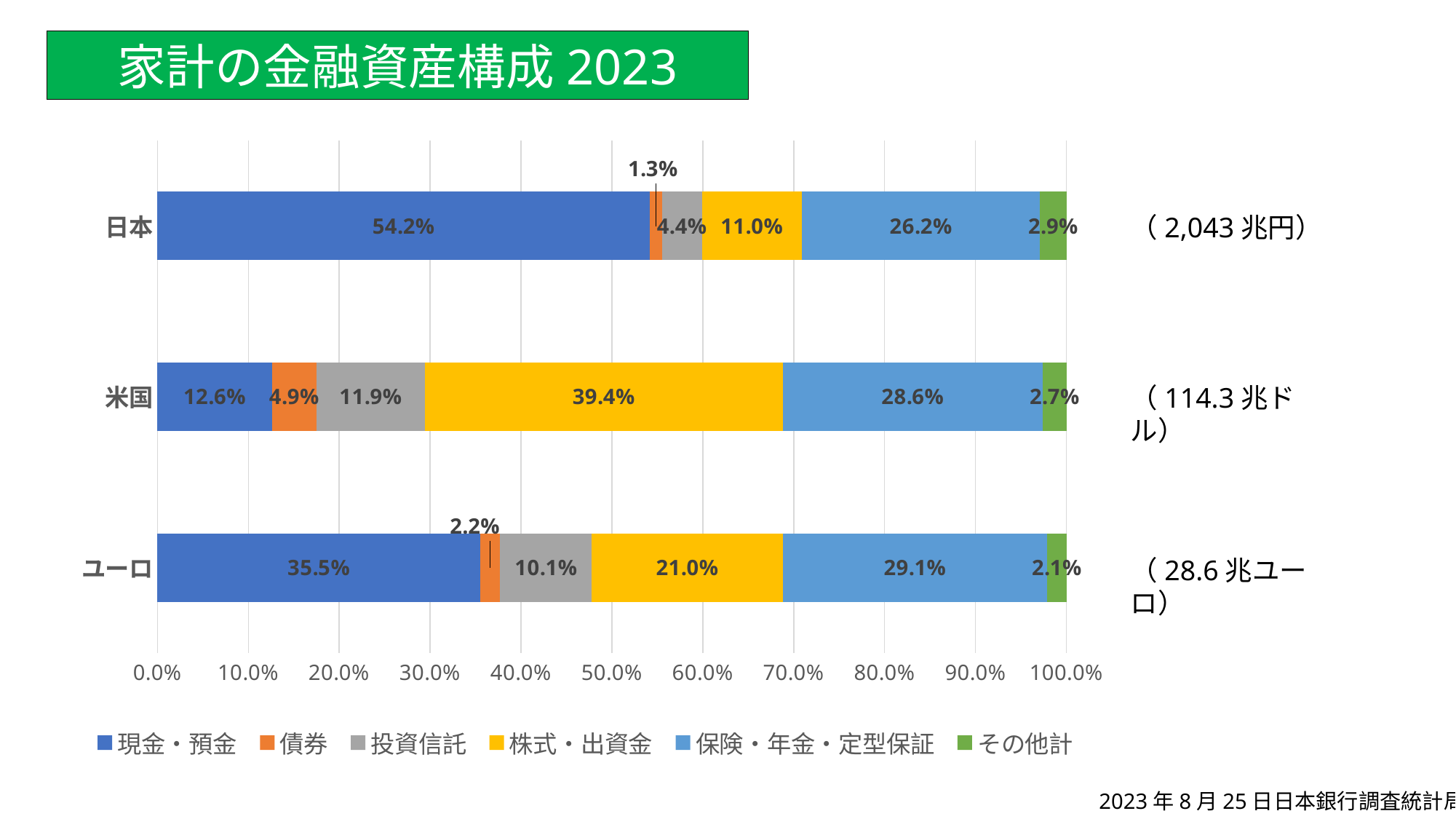
What is the title of the chart on the slide? 家計の金融資産構成 2023 What type of chart is shown on the slide? Stacked bar chart How many series does the legend list? 6 Which region has the lowest share of 株式・出資金? 日本 What is the value of 現金・預金 for 日本? 54.2% Which region has the highest share of 現金・預金? 日本 What is the value of 保険・年金・定型保証 for ユーロ? 29.1% What is the value of 株式・出資金 for 米国? 39.4% Which is larger: the 投資信託 share of 米国 or of ユーロ? 米国 What is the difference between the 株式・出資金 share of 米国 and that of ユーロ? 18.4% How many categories (regions) are plotted on the chart? 3 What is the value of 債券 for 日本? 1.3%